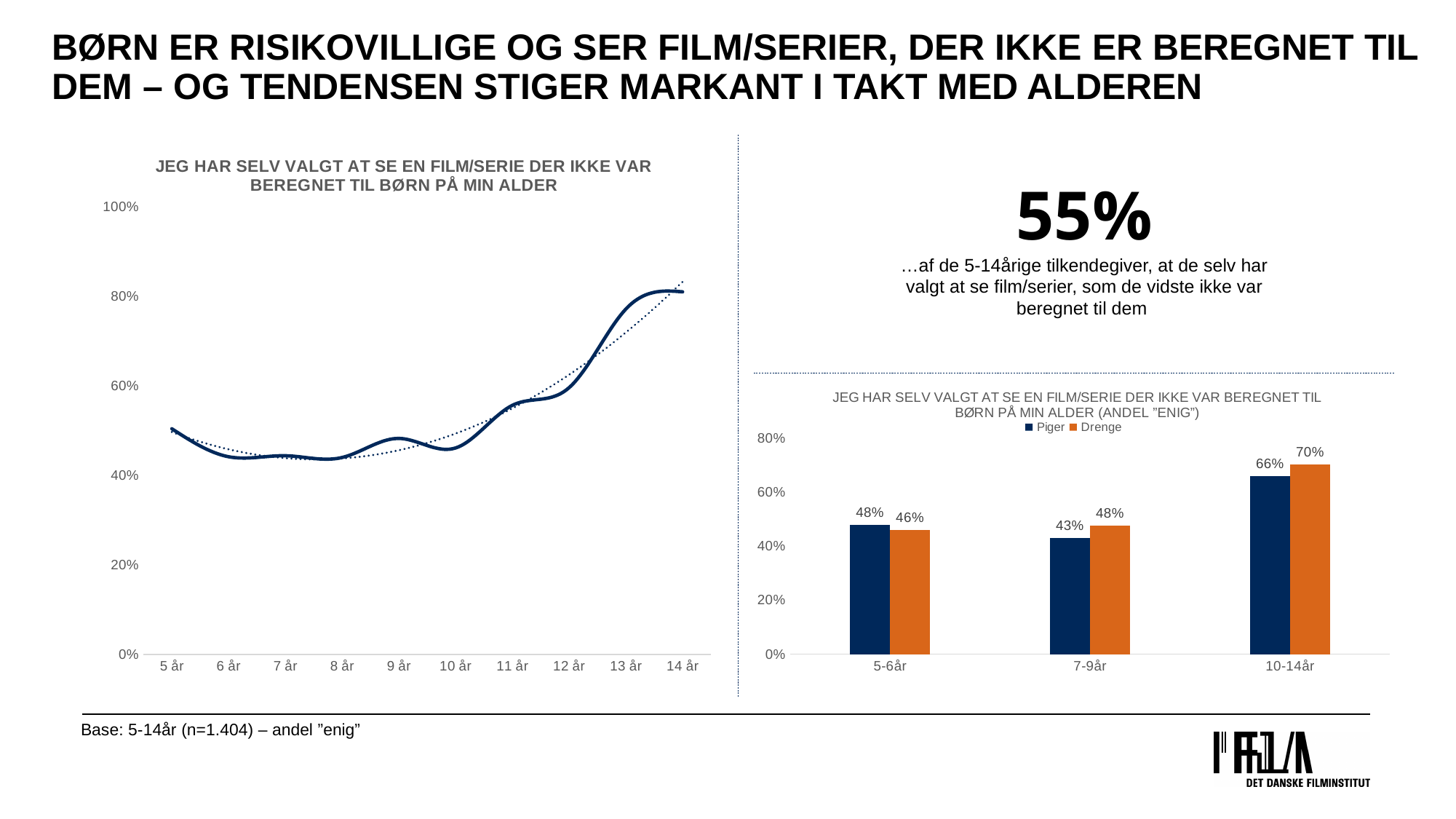
In the chart on the right, how many series does the legend list? 2 What kind of chart is the chart on the left of the slide? line chart In the chart on the right, which age group has the highest value for Drenge? 10-14år In the chart on the left, is the value for 13 år greater or less than 60%? greater In the chart on the right, what is the value for Piger in the 7-9år group? 43% In the chart on the right, which is larger in the 7-9år group, Piger or Drenge? Drenge In the chart on the left, is the value for 8 år greater or less than 60%? less What kind of chart is the chart on the right of the slide? bar chart In the chart on the left, is the value for 5 år greater or less than 40%? greater In the chart on the left, do the values generally rise or fall from 5 år to 14 år? rise In the chart on the left, how many age categories are shown on the x axis? 10 In the chart on the right, what is the difference between Drenge and Piger in the 10-14år group? 4 percentage points